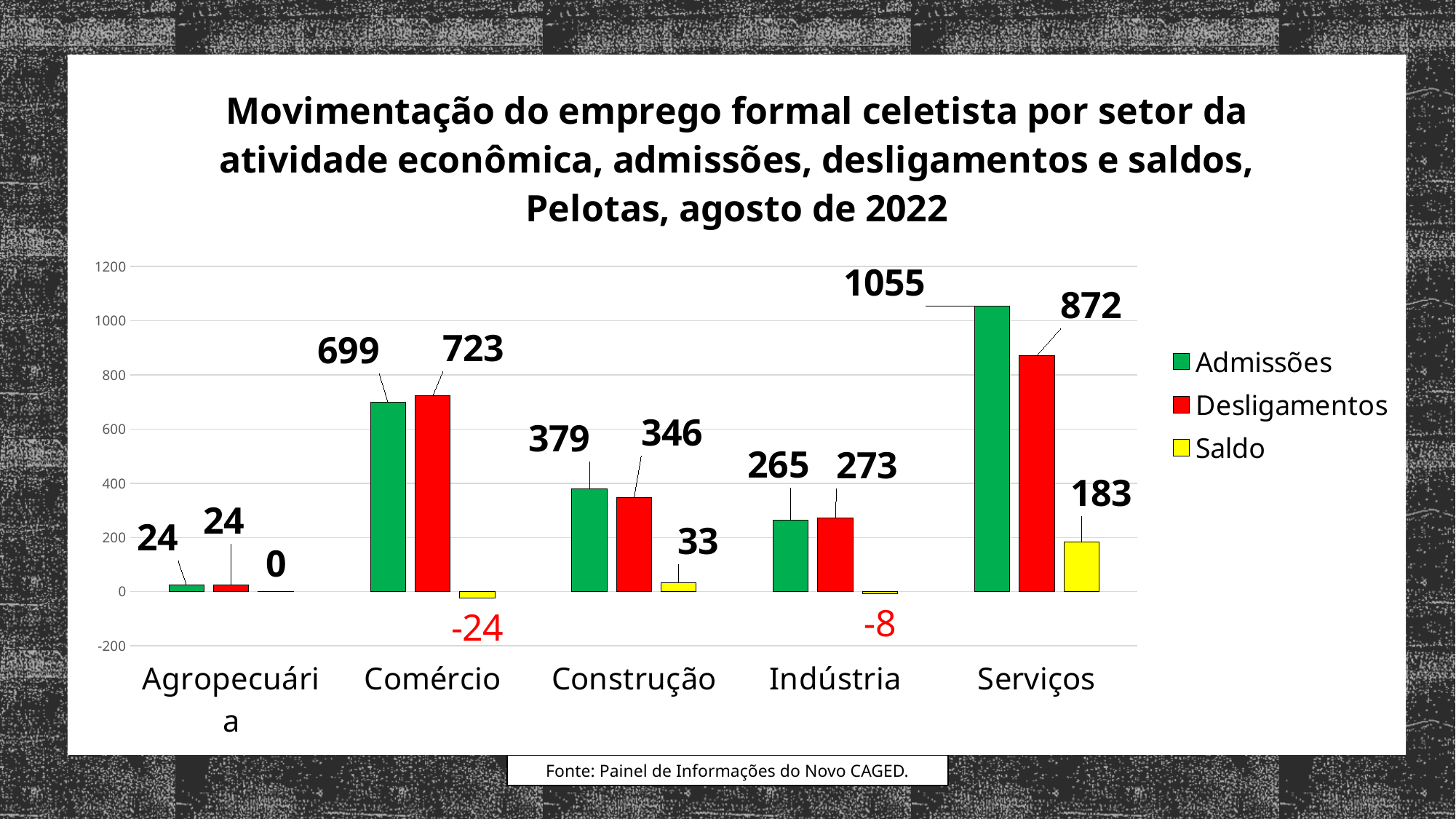
What is the value of Desligamentos for Comércio? 723 Which colour represents the Saldo series? Yellow How many sectors are shown on the x axis? 5 How many series does the legend list? 3 What is the difference between Admissões and Desligamentos for Serviços? 183 Which is larger for Construção, Admissões or Desligamentos? Admissões What kind of chart is shown on the slide? Bar chart What is the Saldo value for Indústria? -8 Which sector has the highest Admissões value? Serviços What is the Saldo value for Construção? 33 What is the value of Admissões for Serviços? 1055 Which sector has the lowest Desligamentos value? Agropecuária